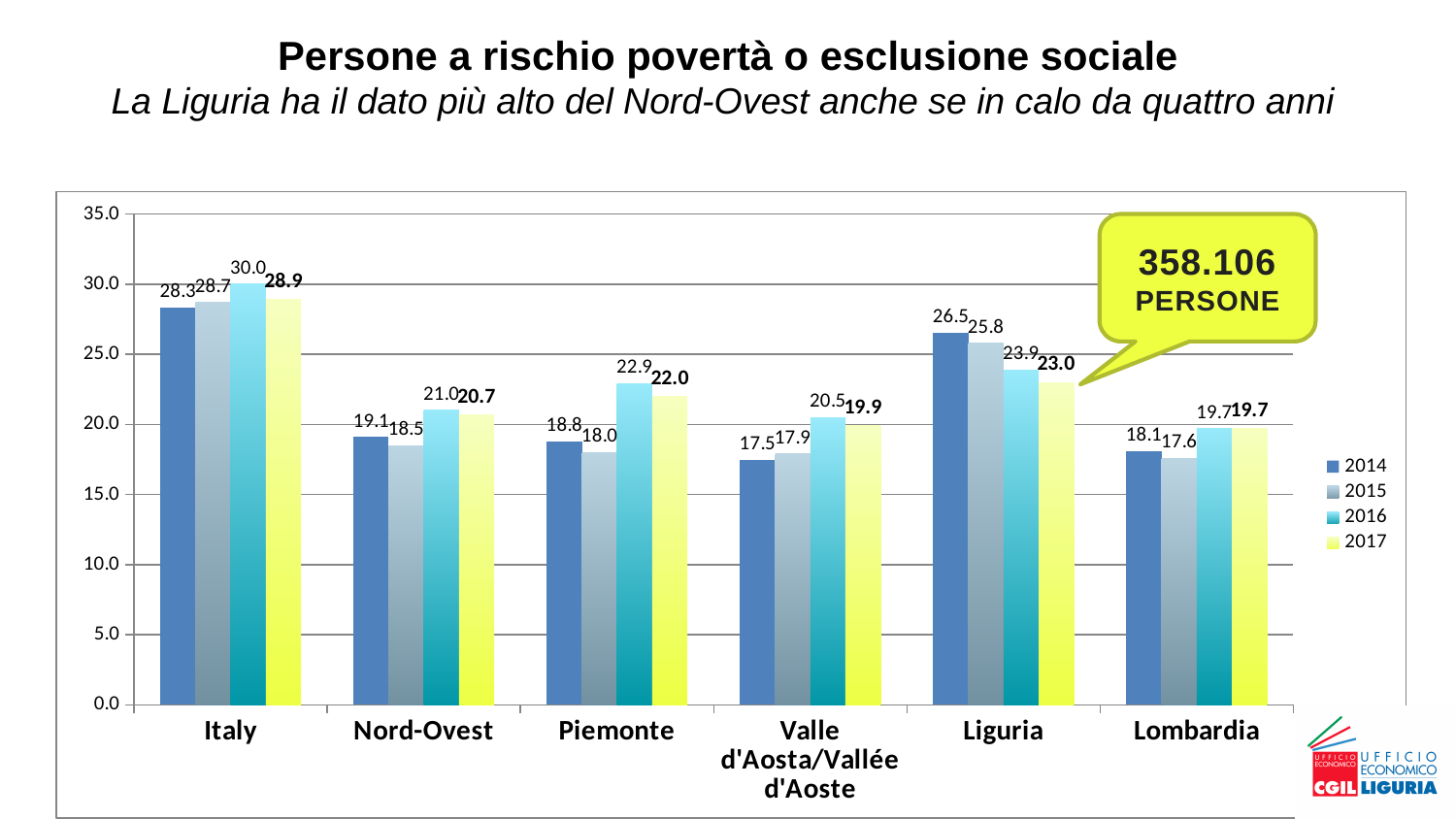
Which category has the lowest value in 2014? Valle d'Aosta/Vallée d'Aoste What is the value for Liguria in 2017? 23.0 What is the difference between the 2014 and 2017 values for Liguria? 3.5 What is the value for Piemonte in 2014? 18.8 Which is larger, the 2016 value for Piemonte or the 2016 value for Lombardia? Piemonte How many categories are shown on the x axis? 6 What kind of chart is shown on the slide? bar chart What is the value for Italy in 2016? 30.0 Which category has the highest value in 2017? Italy Do the values for Liguria rise or fall from 2014 to 2017? fall How many series does the legend list? 4 Is the 2015 value for Nord-Ovest greater or less than 20.0? less